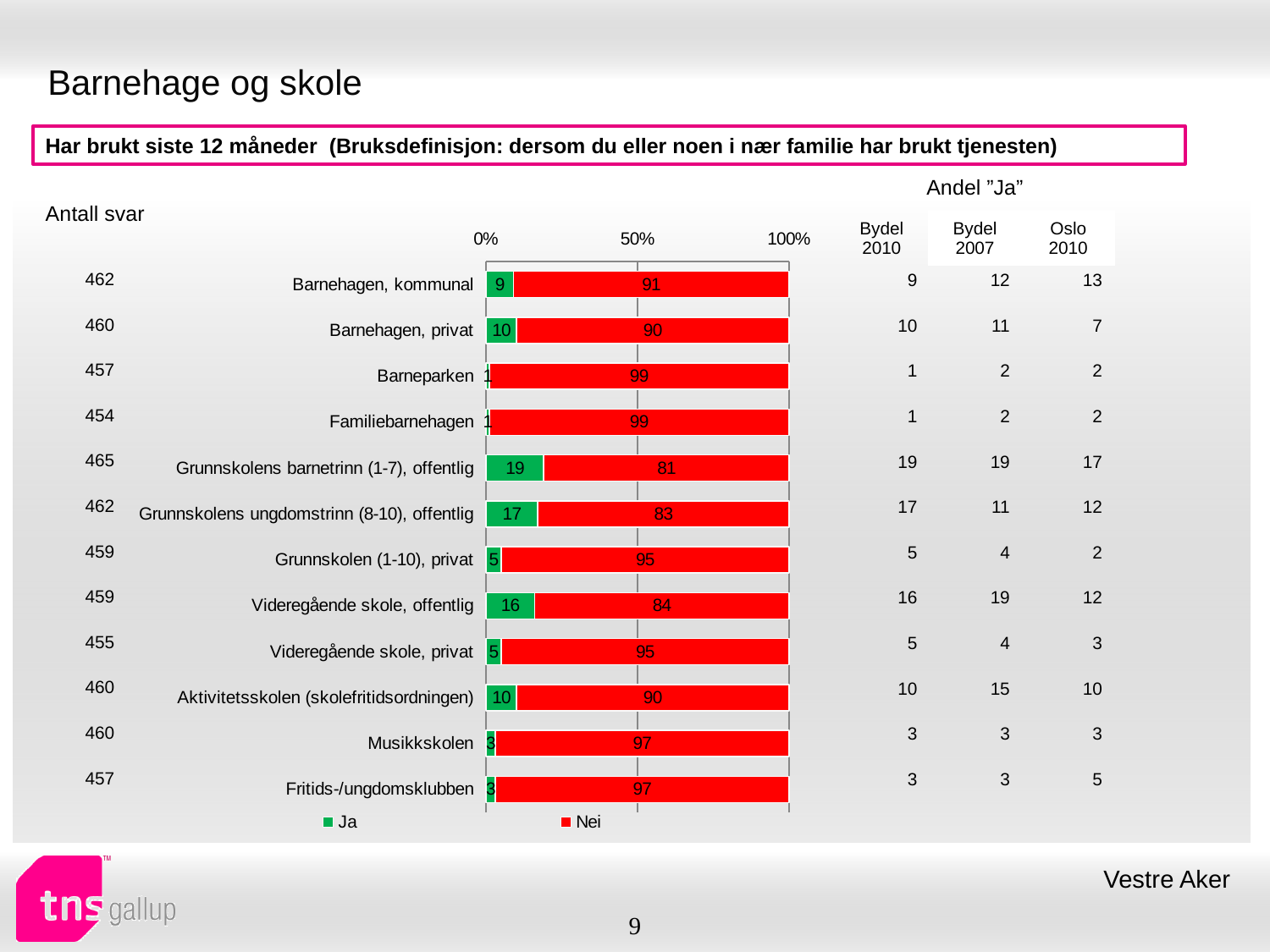
What is the difference between the "Ja" values for Grunnskolens barnetrinn (1-7), offentlig and Grunnskolens ungdomstrinn (8-10), offentlig? 2 What is the total of the stacked bar for Aktivitetsskolen (skolefritidsordningen)? 100 Which is larger, the "Ja" value for Barnehagen, privat or for Grunnskolen (1-10), privat? Barnehagen, privat What is the "Nei" value for Barnehagen, kommunal? 91 What kind of chart is shown on the slide? Stacked bar chart How many series does the legend list? 2 Which category has the highest "Nei" value? Barneparken and Familiebarnehagen (99) How many categories are shown in the bar chart? 12 What is the "Ja" value for Grunnskolens barnetrinn (1-7), offentlig? 19 Which category has the highest "Ja" value? Grunnskolens barnetrinn (1-7), offentlig What is the "Ja" value for Videregående skole, offentlig? 16 Is the "Nei" value for Musikkskolen greater or less than 50%? greater